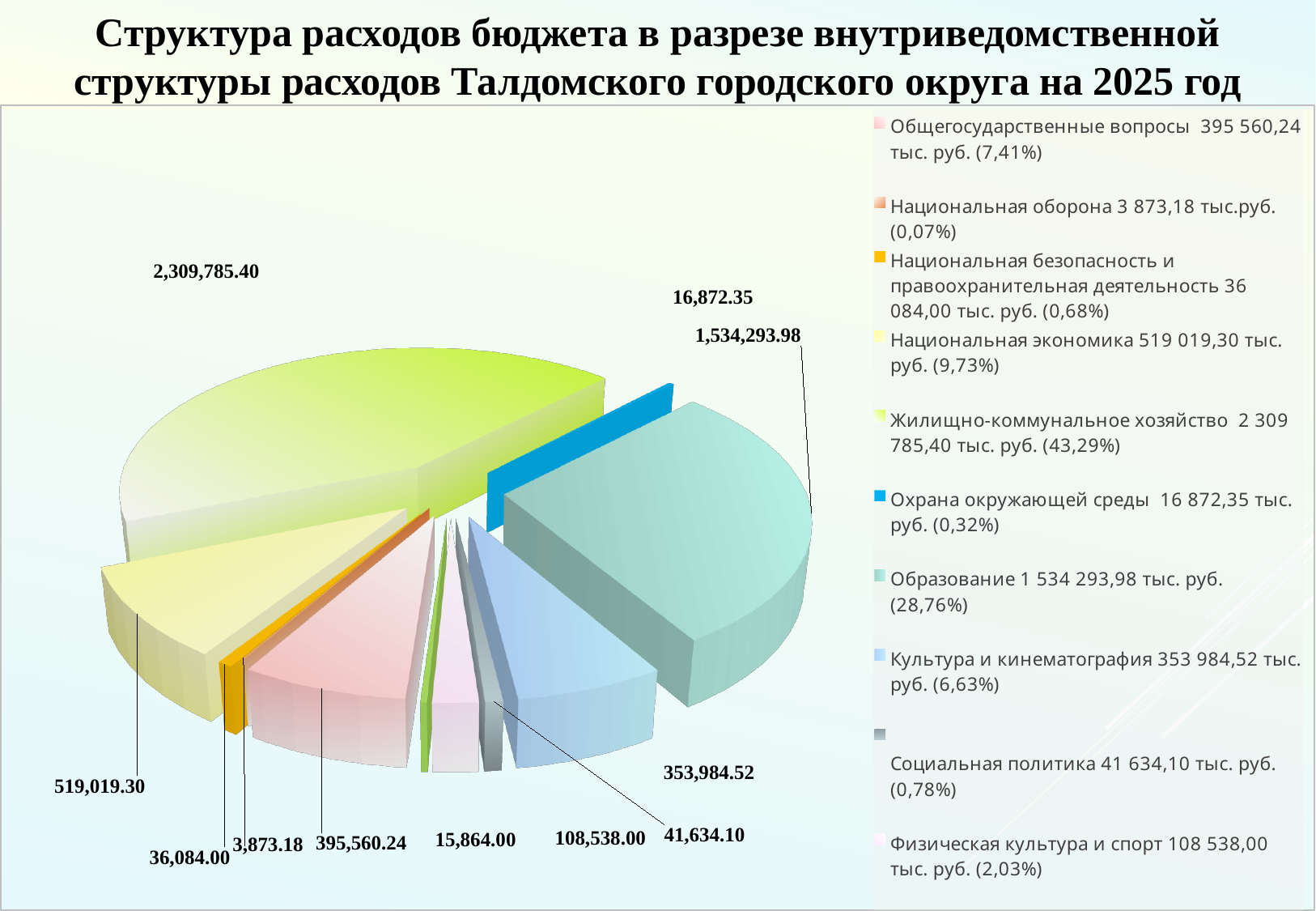
How many entries does the legend list? 10 What is the value labelled for the Национальная экономика slice? 519,019.30 What is the value labelled for the Образование slice? 1,534,293.98 What share of the pie does Образование represent, according to the legend? 28,76% What is the value labelled for the Культура и кинематография slice? 353,984.52 What is the value labelled for the Жилищно-коммунальное хозяйство slice? 2,309,785.40 What is the difference between the Жилищно-коммунальное хозяйство value and the Образование value? 775,491.42 Which is larger, the Образование slice or the Национальная экономика slice? Образование Which category has the smallest slice of the pie? Национальная оборона What share of the pie does Жилищно-коммунальное хозяйство represent, according to the legend? 43,29% What kind of chart is shown on the slide? pie chart Which category has the largest slice of the pie? Жилищно-коммунальное хозяйство